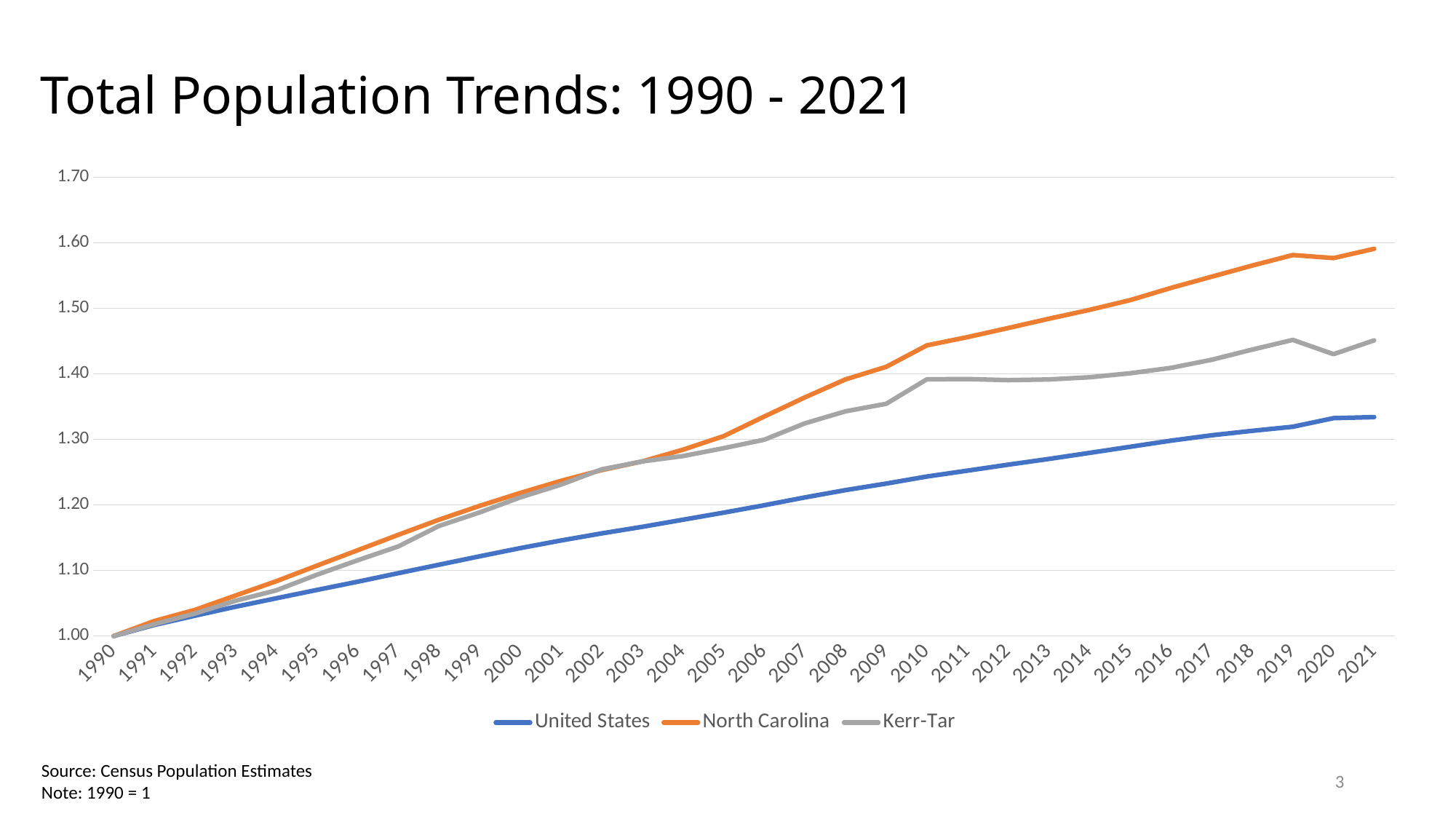
What kind of chart is shown on the slide? line chart Does the United States line rise or fall from 1990 to 2021? rise In 2021, which is larger: the value for North Carolina or the value for United States? North Carolina What colour is the line for Kerr-Tar? gray How many years are plotted along the x axis? 32 Is the value for United States in 2021 greater or less than 1.40? less Which series has the lowest value in 2021? United States What is the value for North Carolina in 1990? 1.00 Is the value for Kerr-Tar in 2005 greater or less than 1.30? less Is the value for North Carolina in 2021 greater or less than 1.50? greater How many series does the legend list? 3 Which series has the highest value in 2021? North Carolina